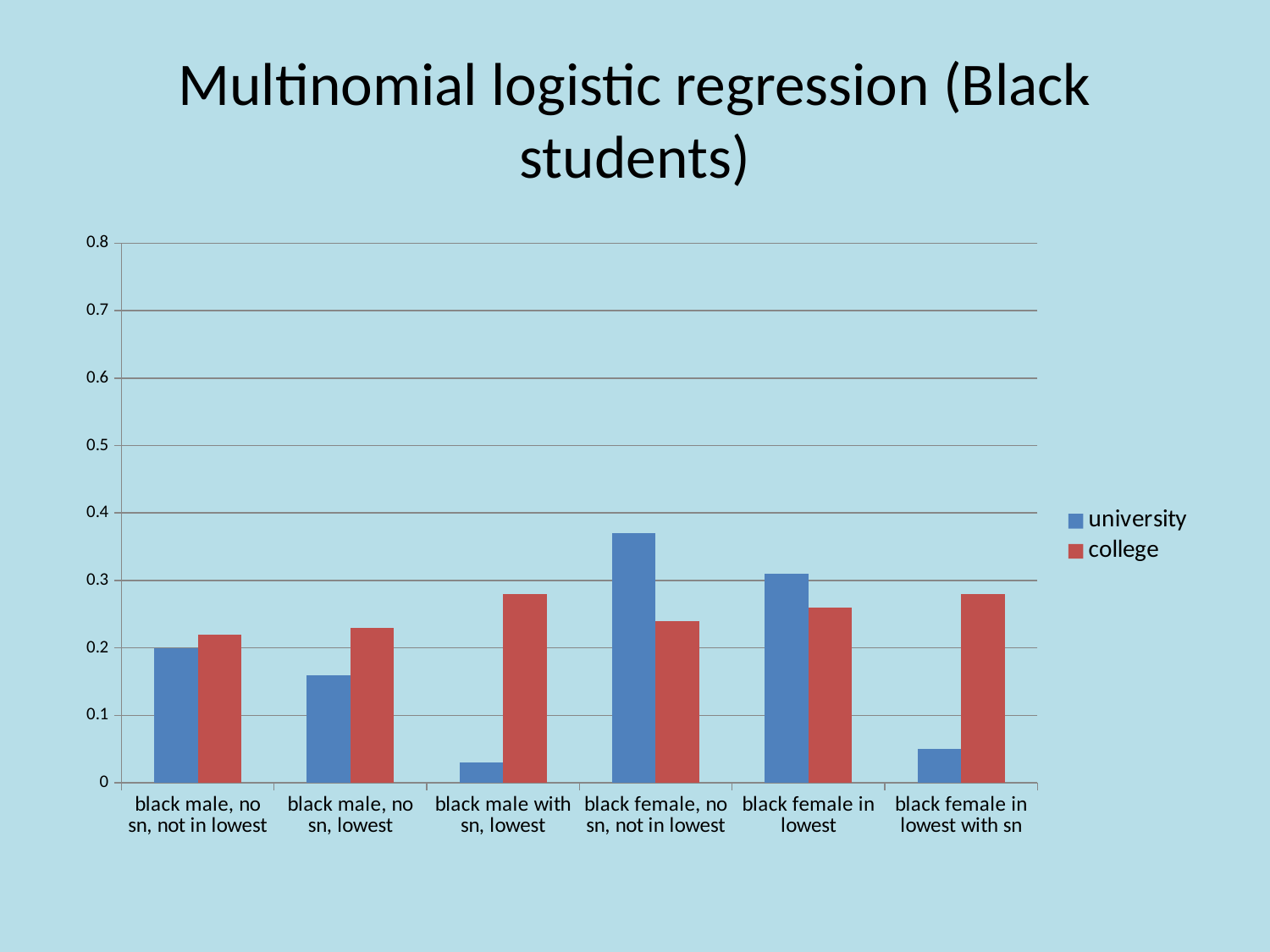
Is the university value for black female, no sn, not in lowest greater or less than 0.3? greater Is the college value for black female in lowest with sn greater or less than 0.2? greater Is the university value for black male with sn, lowest greater or less than 0.1? less How many series does the legend list? 2 For black female, no sn, not in lowest, which is larger: university or college? university How many categories are shown on the x axis? 6 Which series is shown in red? college Which category has the lowest university value? black male with sn, lowest Which category has the highest university value? black female, no sn, not in lowest For black male with sn, lowest, which is larger: university or college? college What is the title of the chart? Multinomial logistic regression (Black students) What kind of chart is shown on the slide? bar chart